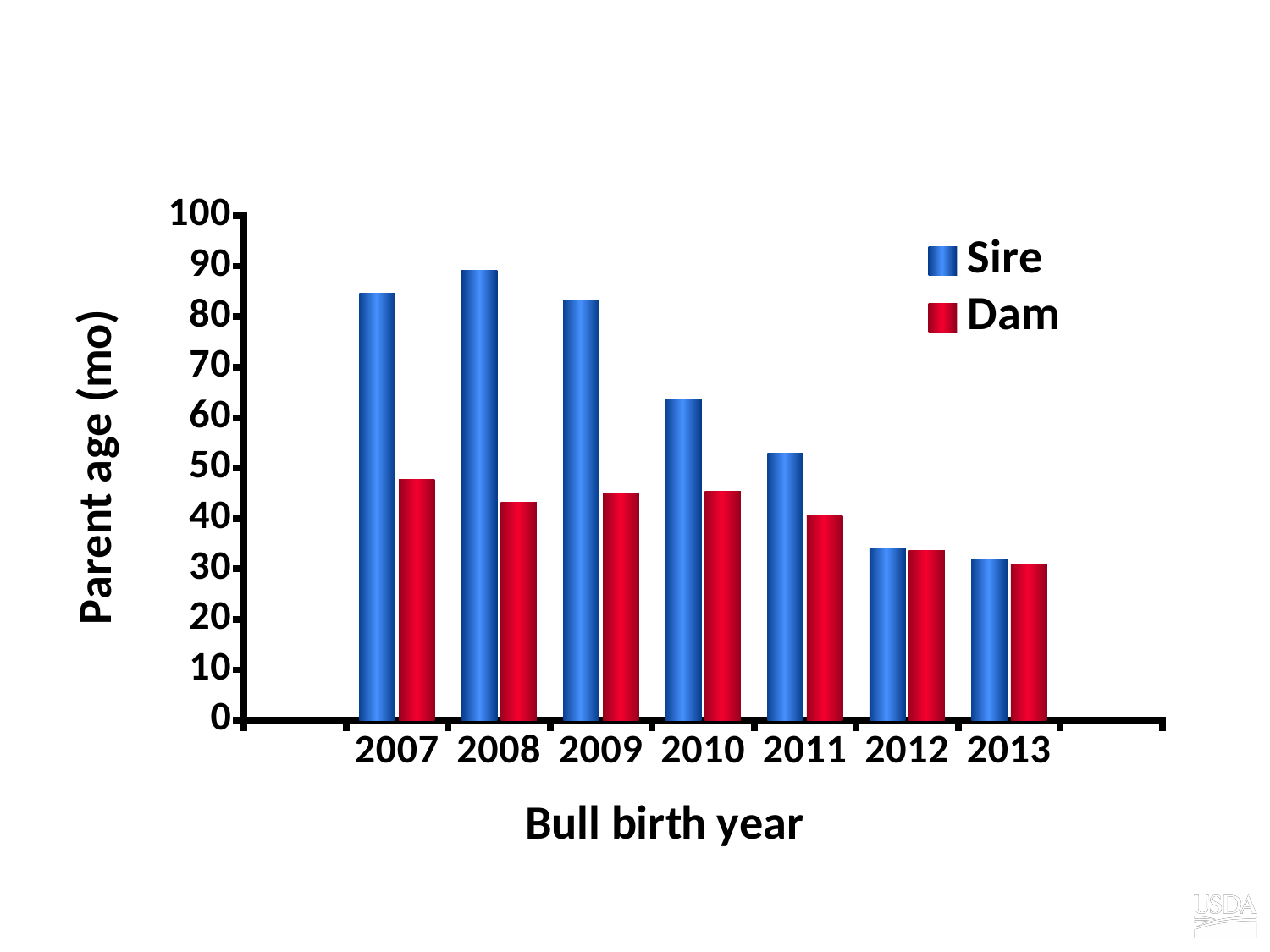
Is the Sire value for 2013 greater or less than 40? less Is the Dam value for 2007 greater or less than 50? less Which bull birth year has the highest Sire parent age? 2008 Is the Sire value for 2010 greater or less than 60? greater Does the Sire parent age rise or fall from 2009 to 2013? fall What is the label of the y axis? Parent age (mo) How many series does the legend list? 2 How many bull birth years are shown on the x axis? 7 What kind of chart is shown on the slide? bar chart Which is larger for 2009, the Sire value or the Dam value? Sire